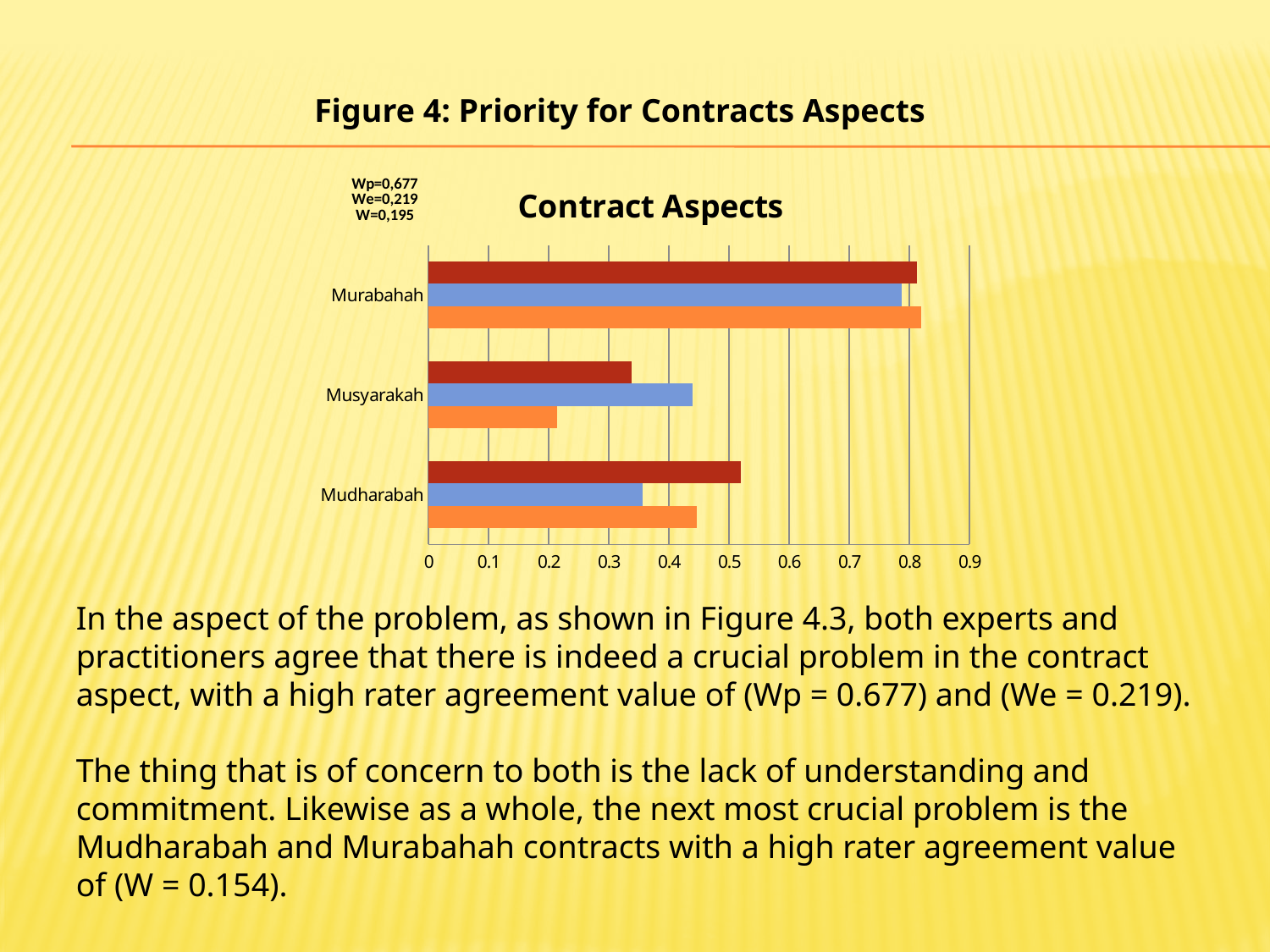
Which category has the longest dark red bar? Murabahah Is the orange bar for Murabahah greater or less than 0.8? greater What is the title of the chart? Contract Aspects What kind of chart is shown on the slide? bar chart Is the dark red bar for Mudharabah greater or less than 0.5? greater Which is larger, the dark red bar for Musyarakah or the dark red bar for Mudharabah? Mudharabah Is the blue bar for Musyarakah greater or less than 0.4? greater Which category has the shortest orange bar? Musyarakah Which is larger, the blue bar for Musyarakah or the orange bar for Musyarakah? the blue bar How many categories are shown on the chart? 3 Which category has the shortest blue bar? Mudharabah